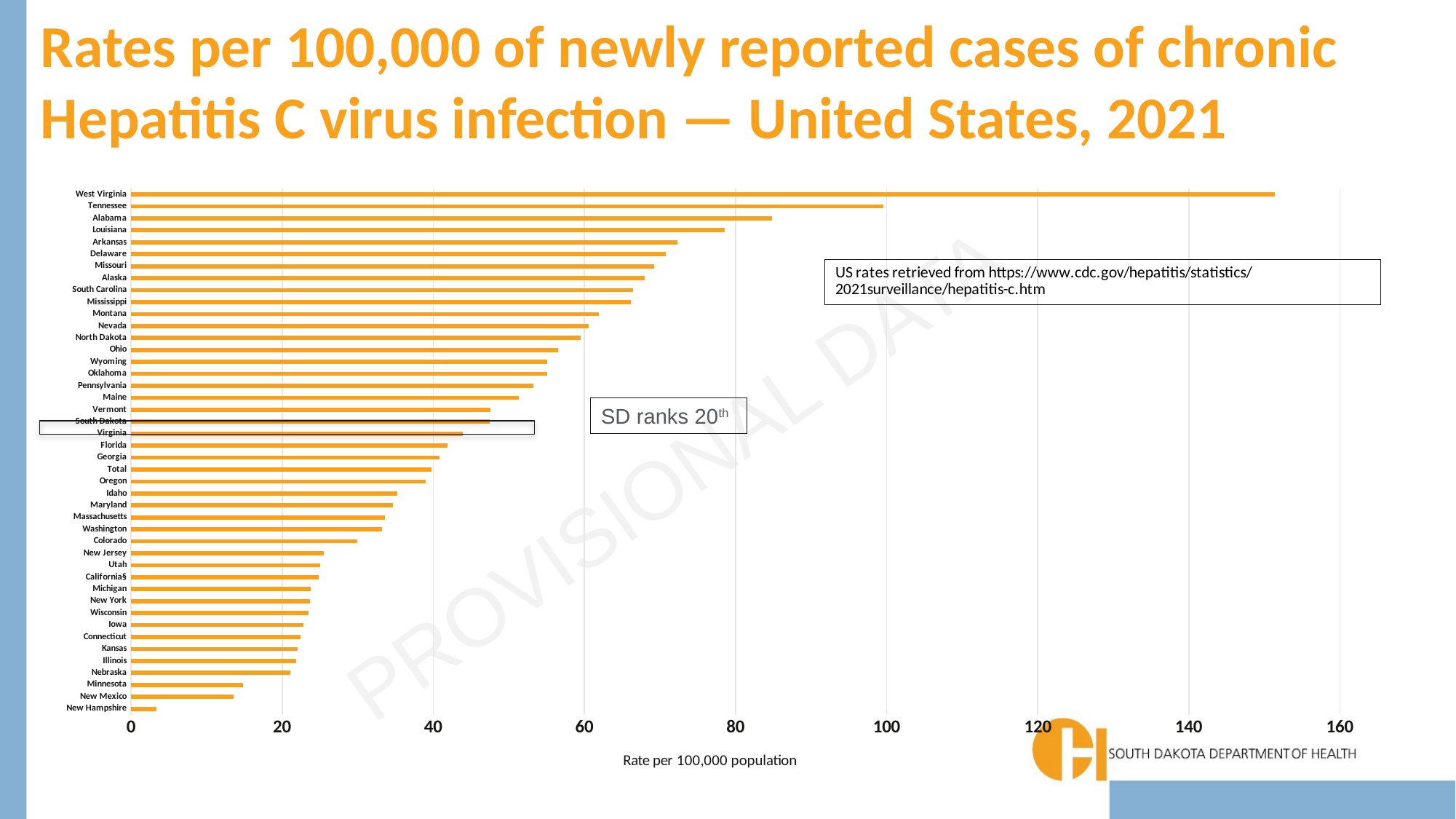
What kind of chart is shown on the slide? bar chart How many bars (categories) are plotted in the chart? 44 Which state has the lowest rate of newly reported chronic Hepatitis C cases? New Hampshire Which has a higher rate, Tennessee or Louisiana? Tennessee Which state has the highest rate of newly reported chronic Hepatitis C cases? West Virginia Is the value for West Virginia greater or less than 140? greater Is the value for Minnesota greater or less than 20? less What is the title of the horizontal axis? Rate per 100,000 population Which has a higher rate, Colorado or Ohio? Ohio Is the value for Alabama greater or less than 80? greater